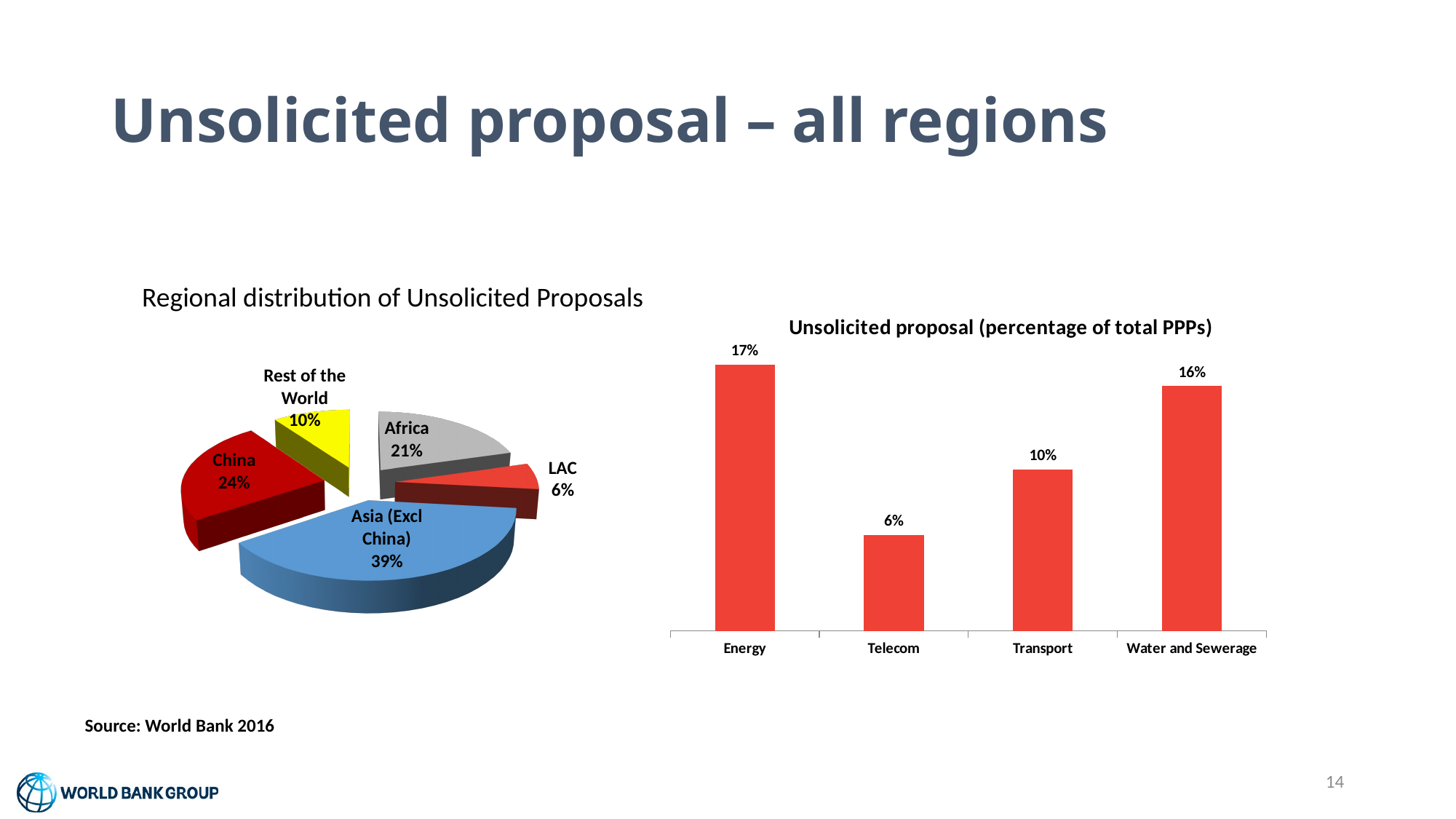
In the 'Unsolicited proposal (percentage of total PPPs)' bar chart, which sector has the lowest value? Telecom In the 'Regional distribution of Unsolicited Proposals' pie chart, what is the difference between Africa and Rest of the World? 11% What type of chart is the 'Unsolicited proposal (percentage of total PPPs)' chart on the right? Bar chart In the 'Regional distribution of Unsolicited Proposals' pie chart, what share does Asia (Excl China) have? 39% In the 'Unsolicited proposal (percentage of total PPPs)' bar chart, what is the value for Transport? 10% In the 'Regional distribution of Unsolicited Proposals' pie chart, what is the value for China? 24% In the 'Regional distribution of Unsolicited Proposals' pie chart, how many slices are there? 5 In the 'Regional distribution of Unsolicited Proposals' pie chart, which region has the largest slice? Asia (Excl China) In the 'Regional distribution of Unsolicited Proposals' pie chart, which region has the smallest slice? LAC In the 'Unsolicited proposal (percentage of total PPPs)' bar chart, what is the difference between Water and Sewerage and Telecom? 10% In the 'Unsolicited proposal (percentage of total PPPs)' chart, which is larger: Energy or Water and Sewerage? Energy In the 'Unsolicited proposal (percentage of total PPPs)' bar chart, which sector has the highest value? Energy